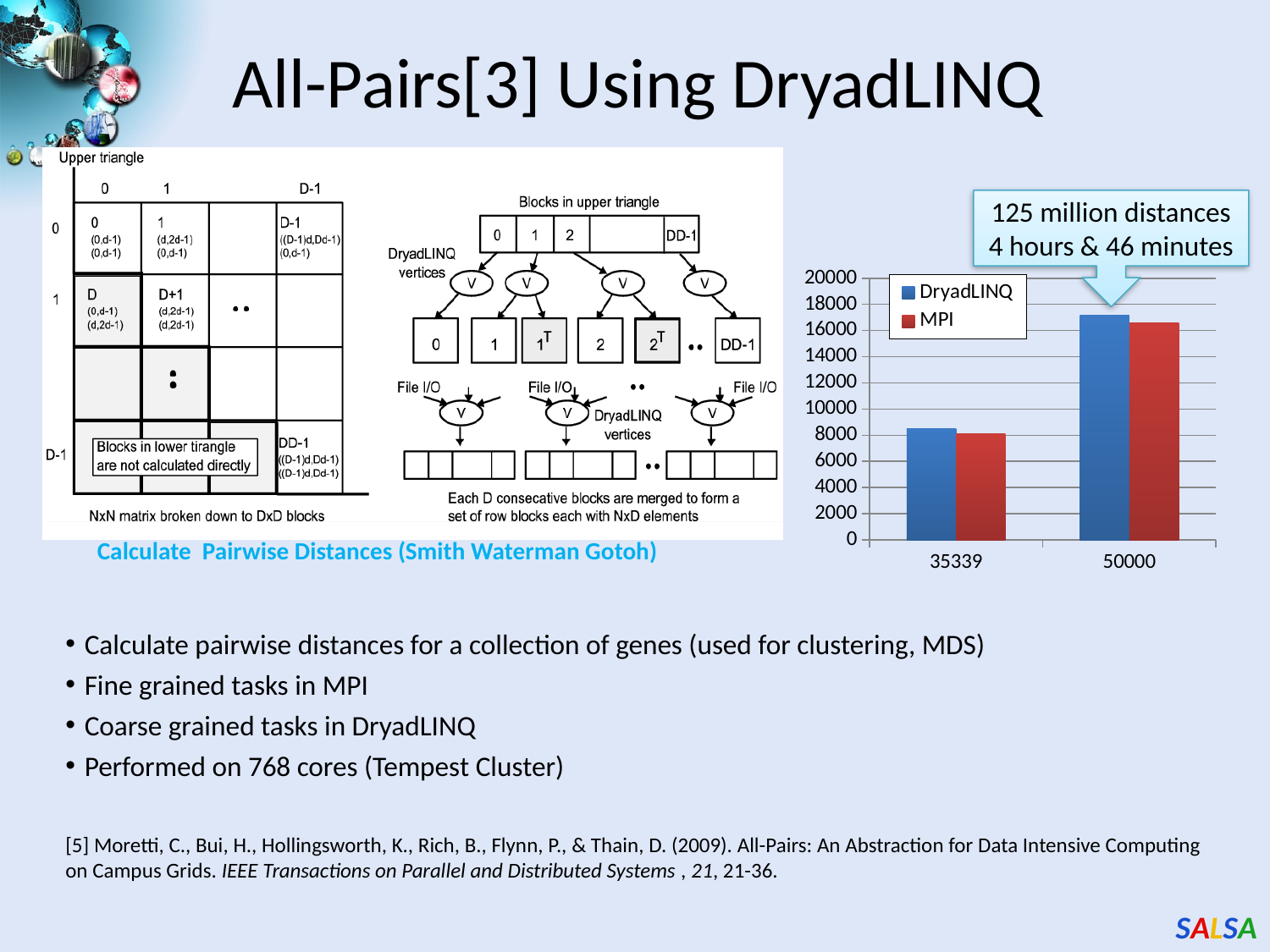
Is the MPI value for 50000 greater or less than 18000? less Which series is shown in blue in the bar chart? DryadLINQ For the 50000 category, which series has the taller bar, DryadLINQ or MPI? DryadLINQ Is the MPI value for 35339 greater or less than 10000? less How many series does the legend of the bar chart list? 2 Which series is shown in red in the bar chart? MPI How many categories are shown on the x axis of the bar chart? 2 Which category has the highest DryadLINQ value in the bar chart? 50000 Is the DryadLINQ value for 50000 greater or less than 16000? greater Do the MPI values rise or fall from 35339 to 50000? rise What kind of chart is shown on the right side of the slide? bar chart